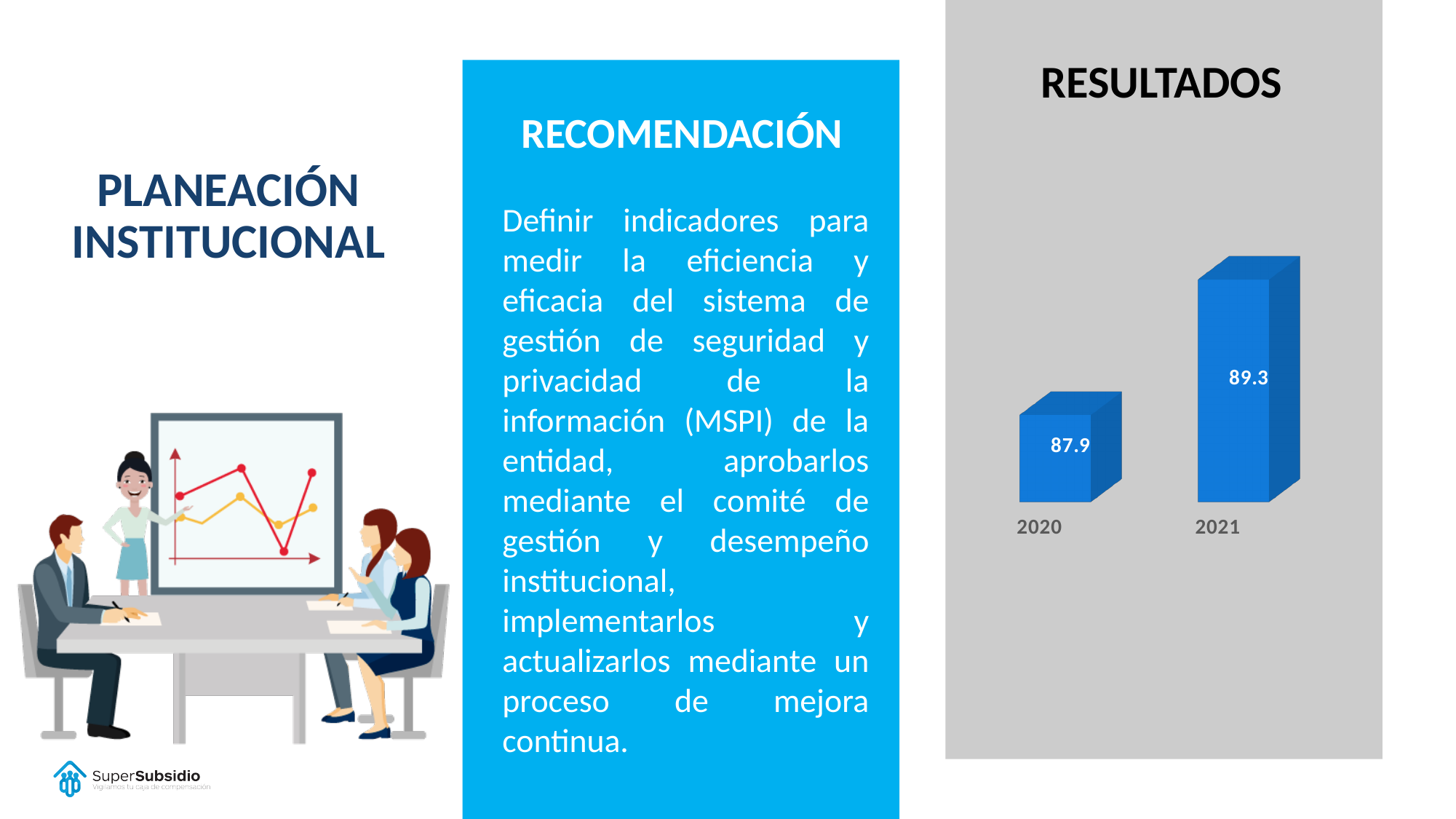
How many bars are shown in the RESULTADOS chart? 2 Which year has the highest value in the RESULTADOS chart? 2021 What kind of chart is the RESULTADOS chart? Bar chart What is the difference between the 2021 and 2020 values in the RESULTADOS chart? 1.4 What is the value for 2020 in the RESULTADOS chart? 87.9 What is the value for 2021 in the RESULTADOS chart? 89.3 Which year has the lowest value in the RESULTADOS chart? 2020 Do the values in the RESULTADOS chart rise or fall from 2020 to 2021? Rise In the RESULTADOS chart, is the value for 2020 or 2021 larger? 2021 What colour are the bars in the RESULTADOS chart? Blue What is the title of the chart on the right side of the slide? RESULTADOS